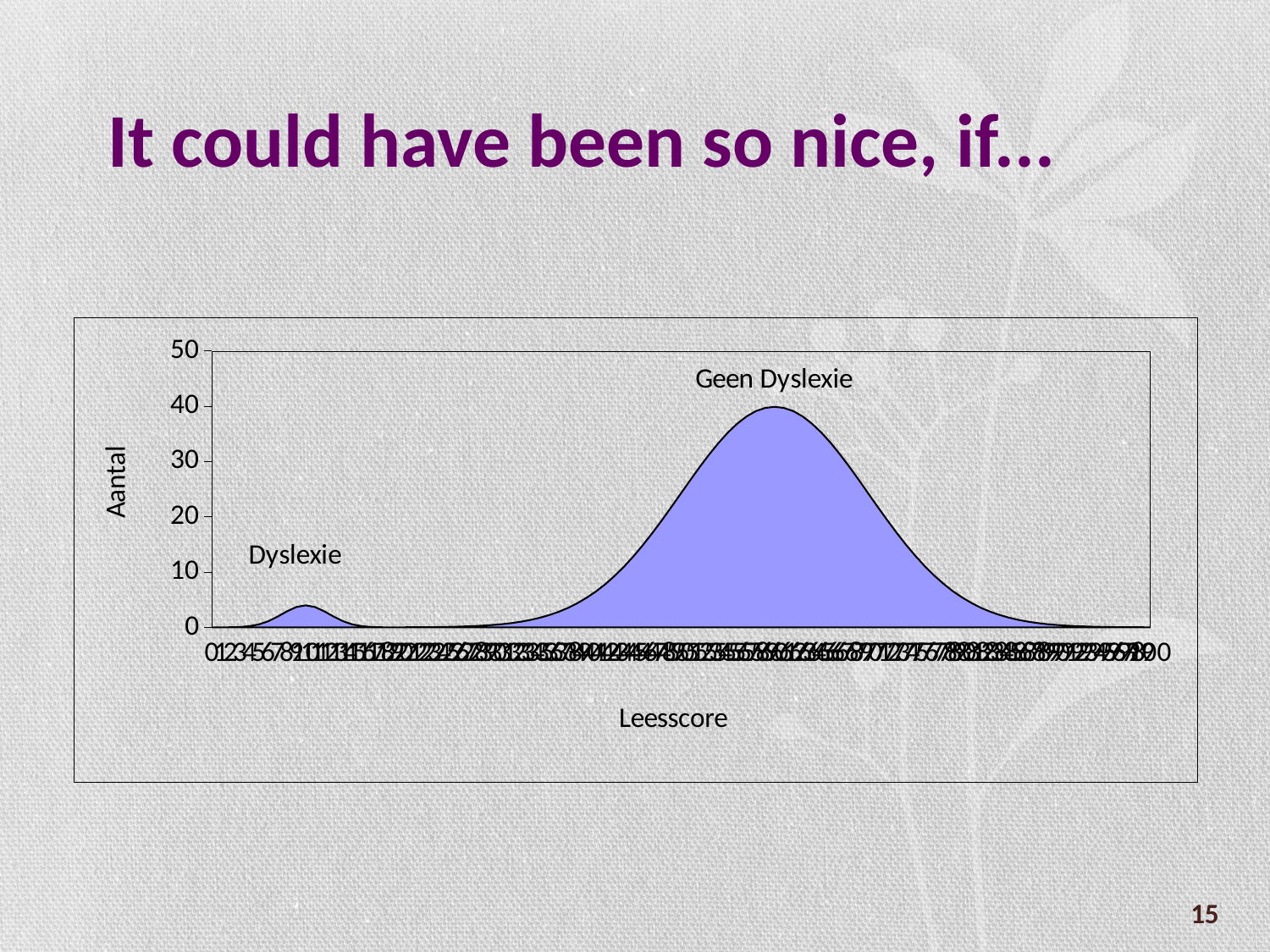
Which labelled group has the lowest peak? Dyslexie What is the highest tick value shown on the vertical axis? 50 Is the peak value for Geen Dyslexie greater or less than 30? greater What is the label on the vertical axis of the chart? Aantal Is the peak value for Dyslexie greater or less than 10? less What is the label on the horizontal axis of the chart? Leesscore How many labelled groups (peaks) are shown in the chart? 2 Is the peak value for Geen Dyslexie greater or less than 50? less Which labelled group has the highest peak? Geen Dyslexie What kind of chart is shown on the slide? Area chart Which of the two labelled groups, Dyslexie or Geen Dyslexie, reaches the higher peak? Geen Dyslexie